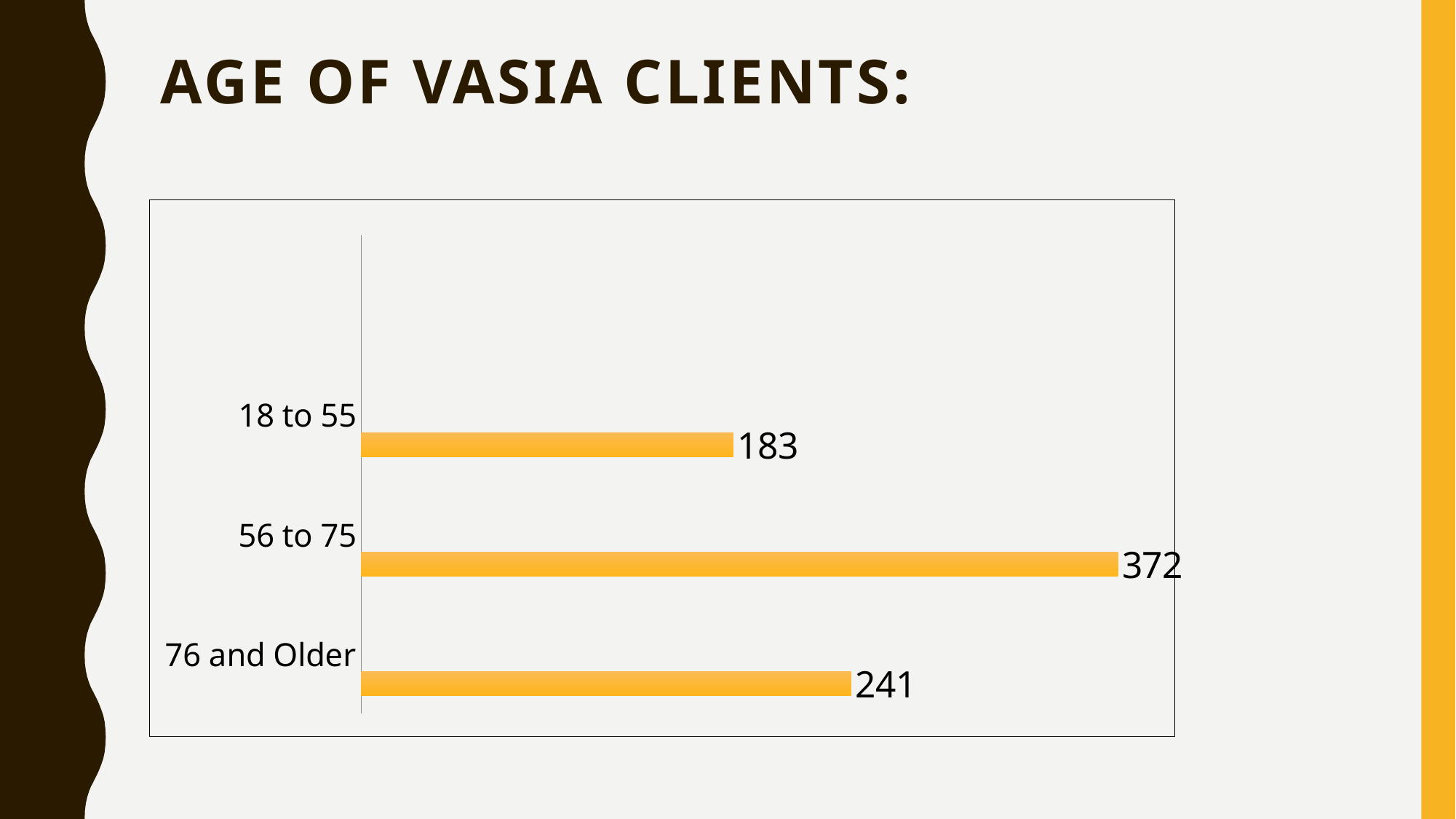
What colour are the bars in the chart? Orange Which age group has the highest value? 56 to 75 Which age group has the lowest value? 18 to 55 What is the value for the 76 and Older age group? 241 What kind of chart is shown on the slide? Bar chart How many age groups are shown in the chart? 3 What is the value for the 18 to 55 age group? 183 What is the value for the 56 to 75 age group? 372 What is the difference between the values for 56 to 75 and 18 to 55? 189 What is the title of the slide? AGE OF VASIA CLIENTS: Which is larger, the value for 76 and Older or the value for 18 to 55? 76 and Older What is the difference between the values for 76 and Older and 18 to 55? 58